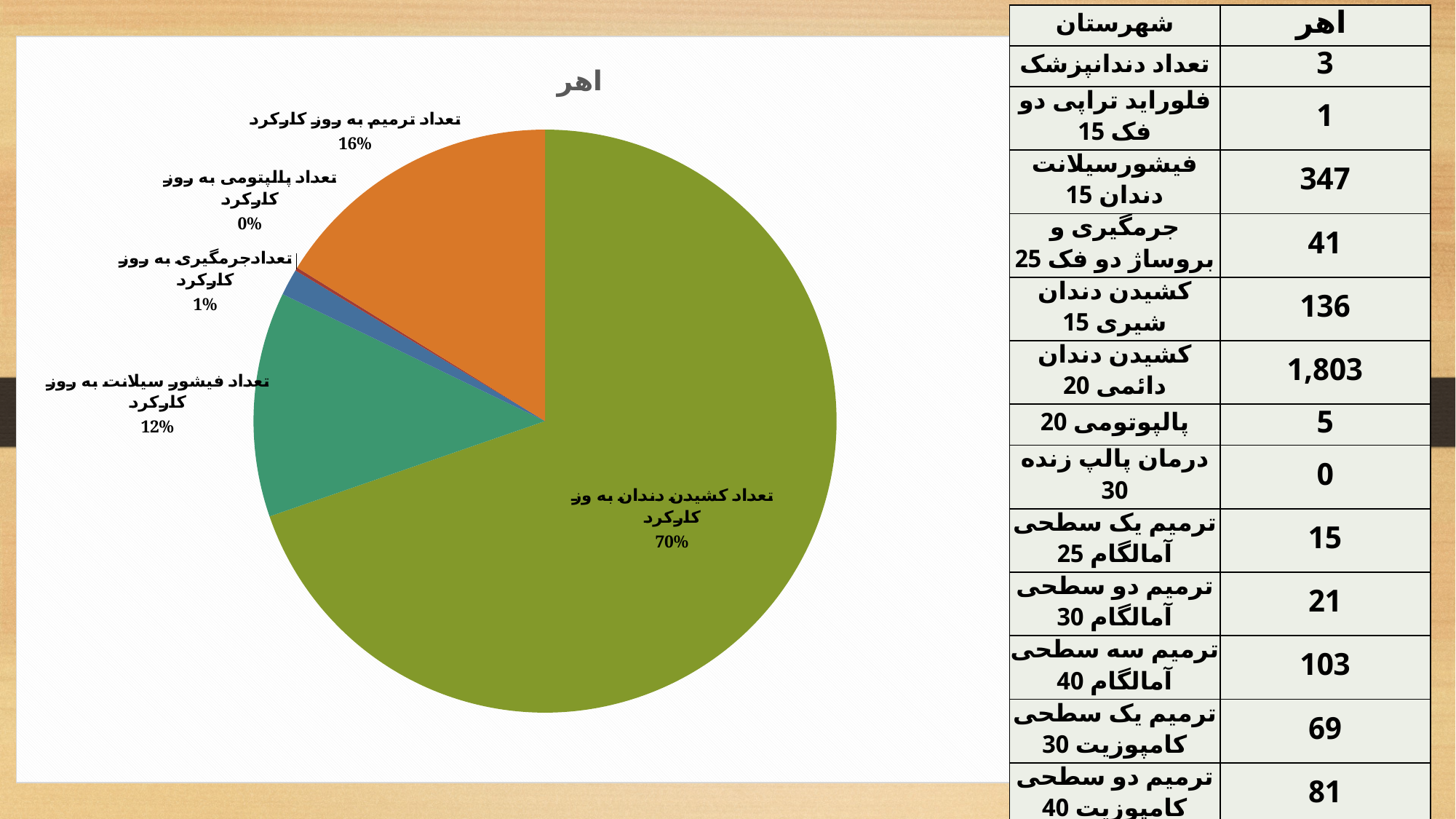
What share of the pie does "تعداد جرمگیری به روز کارکرد" have? 1% What share of the pie does "تعداد کشیدن دندان به روز کارکرد" have? 70% What is the title of the pie chart? اهر What is the difference in percentage points between the "تعداد کشیدن دندان به روز کارکرد" slice and the "تعداد ترمیم به روز کارکرد" slice? 54% What kind of chart is shown on the slide? pie chart Which slice of the pie chart is the smallest? تعداد پالپتومی به روز کارکرد Which slice of the pie chart is the largest? تعداد کشیدن دندان به روز کارکرد What share of the pie does "تعداد ترمیم به روز کارکرد" have? 16% Which is larger in the pie chart: "تعداد ترمیم به روز کارکرد" or "تعداد فیشور سیلانت به روز کارکرد"? تعداد ترمیم به روز کارکرد How many slices does the pie chart have? 5